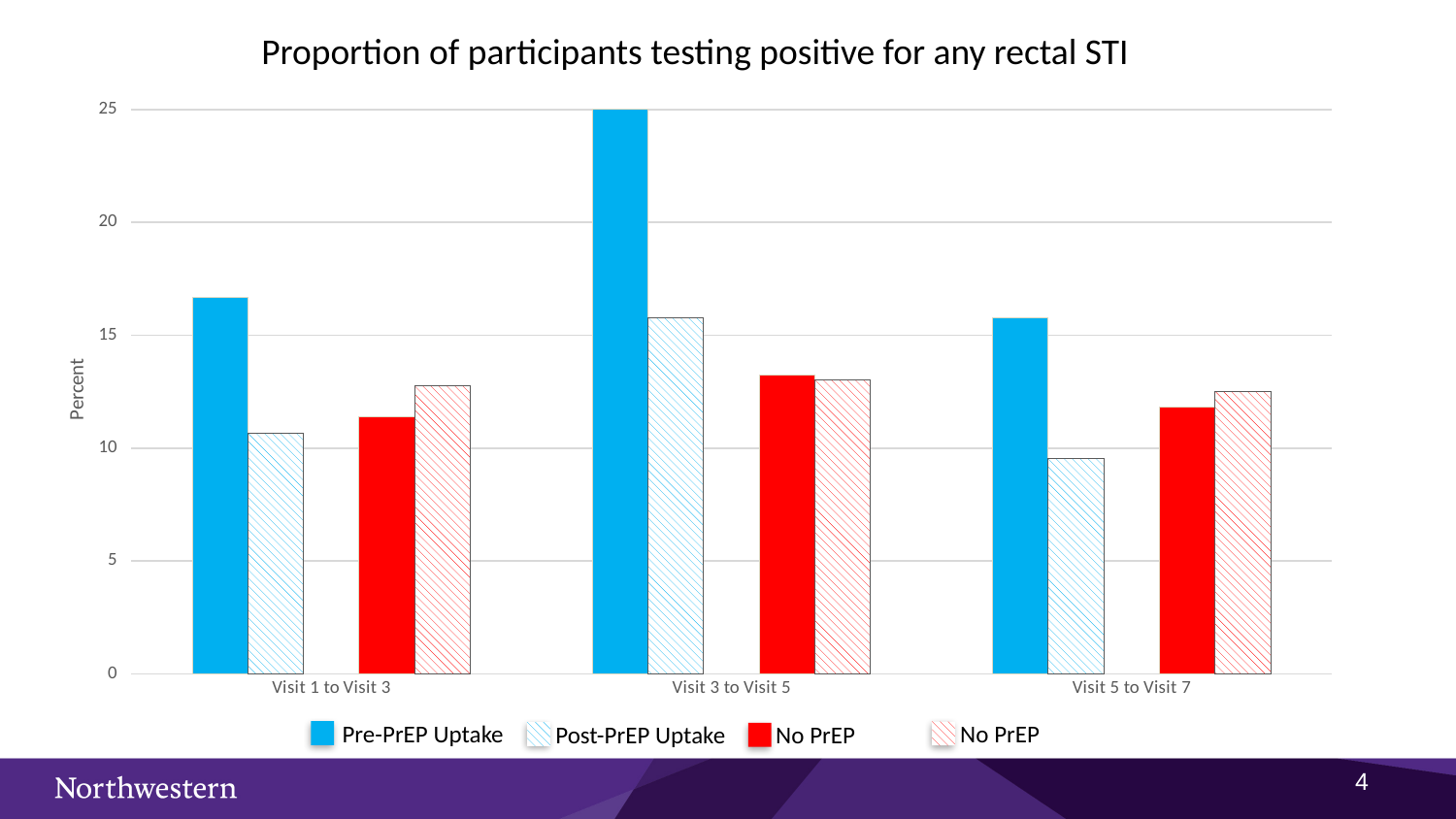
Is the Pre-PrEP Uptake value for Visit 1 to Visit 3 greater or less than 15? greater What kind of chart is shown on the slide? bar chart For which visit interval is the Post-PrEP Uptake bar lowest? Visit 5 to Visit 7 How many visit-interval categories are shown on the x axis? 3 How many series does the legend list? 4 Is the solid red No PrEP value for Visit 3 to Visit 5 greater or less than 15? less Is the Post-PrEP Uptake value for Visit 5 to Visit 7 greater or less than 10? less What is the title of the chart? Proportion of participants testing positive for any rectal STI For which visit interval is the Pre-PrEP Uptake bar highest? Visit 3 to Visit 5 What is the label on the vertical axis? Percent What is the Pre-PrEP Uptake value for Visit 3 to Visit 5? 25 In Visit 3 to Visit 5, which is larger: Pre-PrEP Uptake or Post-PrEP Uptake? Pre-PrEP Uptake